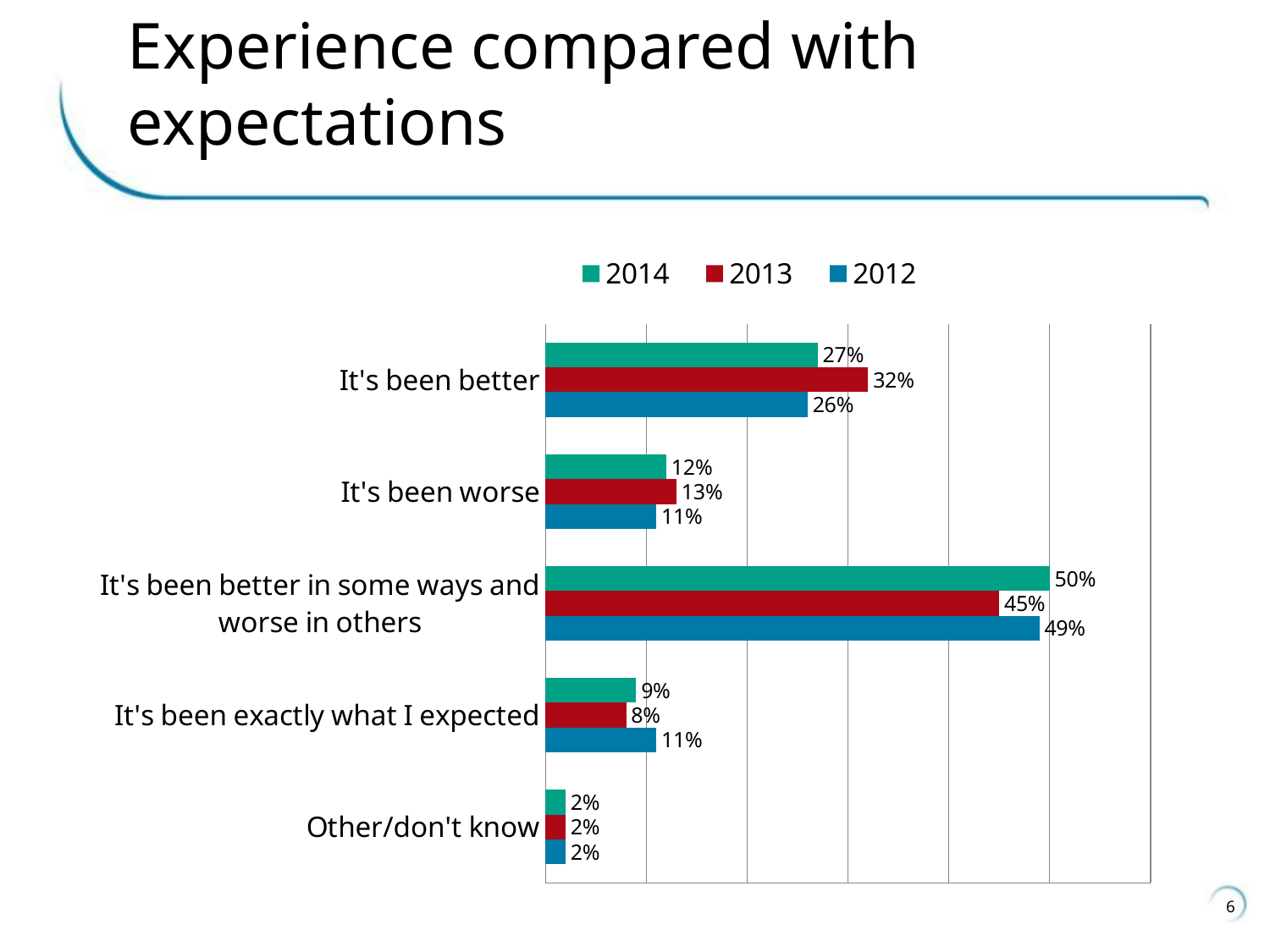
What is the 2014 value for "It's been better"? 27% What is the 2012 value for "It's been exactly what I expected"? 11% How many categories are shown on the chart? 5 Which category has the highest 2014 value? It's been better in some ways and worse in others What kind of chart is shown on the slide? Bar chart What is the difference between the 2013 and 2012 values for "It's been better"? 6% How many series does the legend list? 3 Which is larger for "It's been worse": the 2013 value or the 2012 value? 2013 Which series is shown in red in the legend? 2013 Which category has the lowest 2013 value? Other/don't know What is the 2013 value for "It's been better in some ways and worse in others"? 45% What is the difference between the 2014 and 2013 values for "It's been better in some ways and worse in others"? 5%